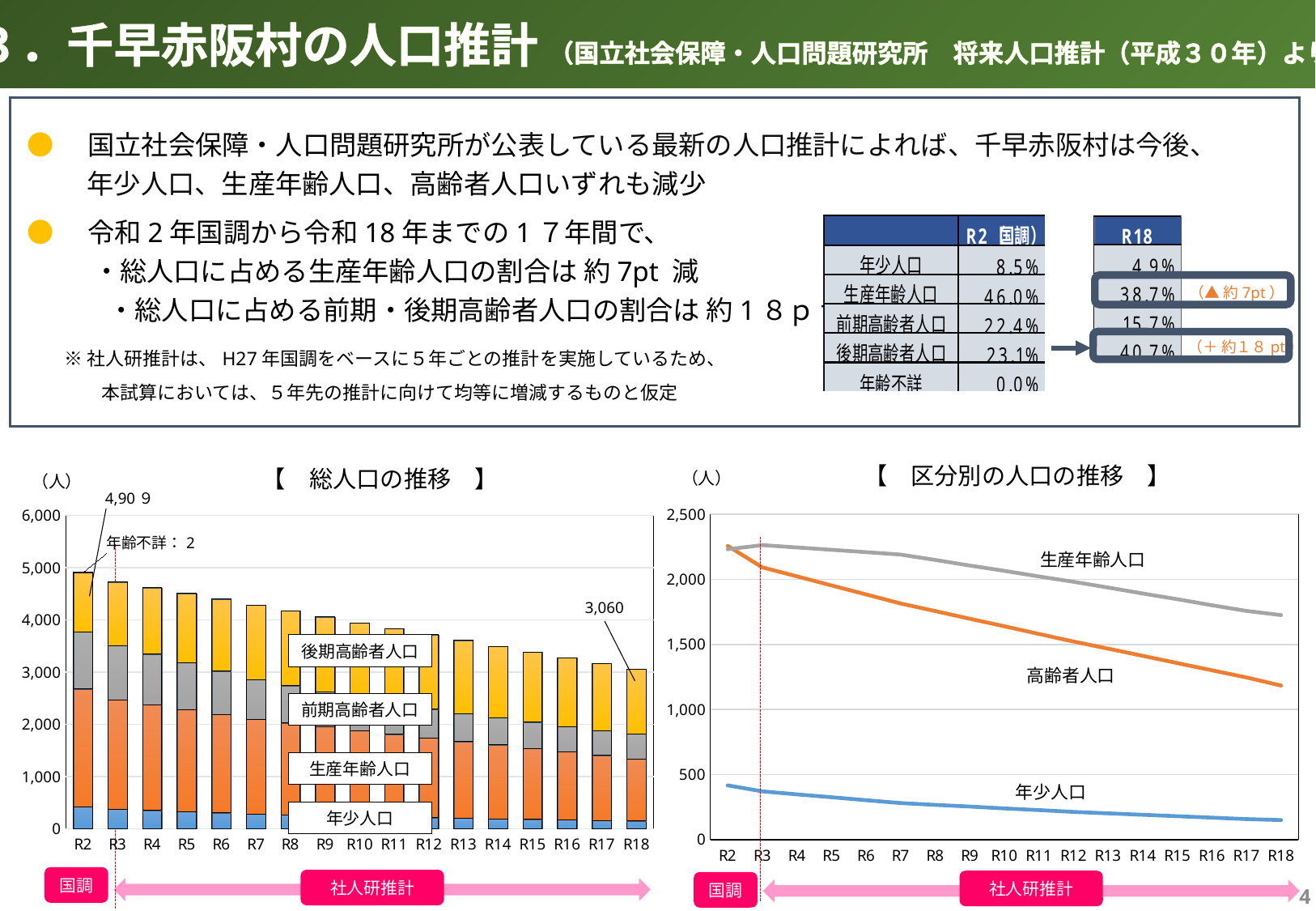
In the 区分別の人口の推移 chart, which series has the lowest values across all years? 年少人口 In the 総人口の推移 chart, what is the difference between the labelled values for R2 and R18? 1,849 In the 総人口の推移 chart, is the total for R13 greater or less than 4,000? less What kind of chart is the 総人口の推移 chart on the left? bar chart How many series (lines) are plotted in the 区分別の人口の推移 chart? 3 In the 総人口の推移 chart, what is the total population value labelled for R18? 3,060 How many years (categories) are shown on the x axis of the 総人口の推移 chart? 17 In the 総人口の推移 chart, what is the total population value labelled for R2? 4,909 What kind of chart is the 区分別の人口の推移 chart on the right? line chart In the 総人口の推移 chart, do the bar totals rise or fall from R2 to R18? fall